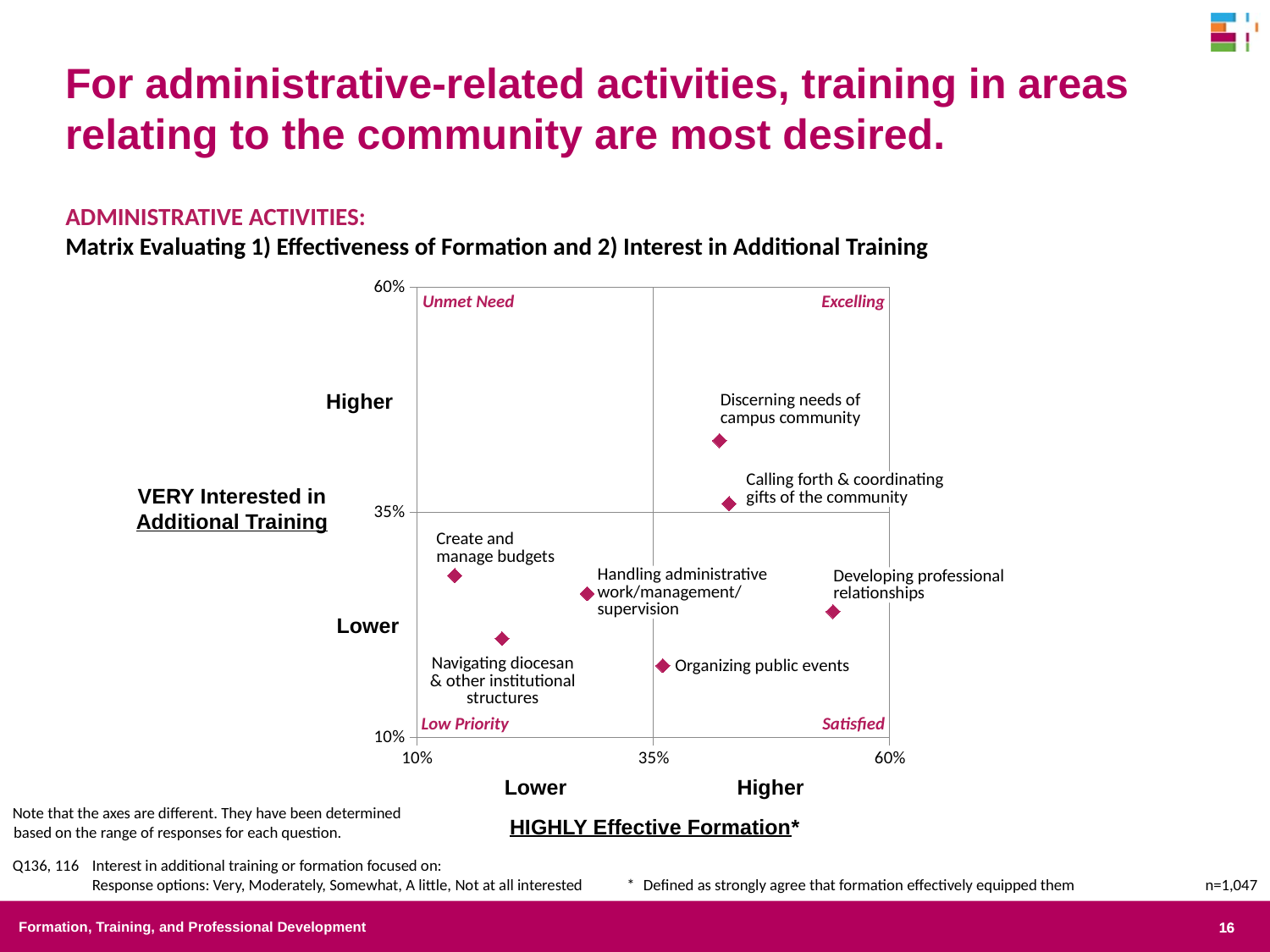
Which activity has the lowest share of respondents very interested in additional training? Organizing public events Which quadrant of the matrix is labeled in the top-right corner? Excelling Which activity has the lowest share of respondents reporting highly effective formation? Create and manage budgets Is the 'VERY Interested in Additional Training' value for Navigating diocesan & other institutional structures greater or less than 35%? less What kind of chart is shown on the slide? Scatter plot Is the 'HIGHLY Effective Formation' value for Create and manage budgets greater or less than 35%? less How many administrative activities are plotted on the chart? 7 Is the 'VERY Interested in Additional Training' value for Discerning needs of campus community greater or less than 35%? greater What is the label of the horizontal axis of the chart? HIGHLY Effective Formation* Which has a higher 'HIGHLY Effective Formation' value: Developing professional relationships or Handling administrative work/management/supervision? Developing professional relationships Which activity has the highest share of respondents very interested in additional training? Discerning needs of campus community Which activity has the highest share of respondents reporting highly effective formation? Developing professional relationships